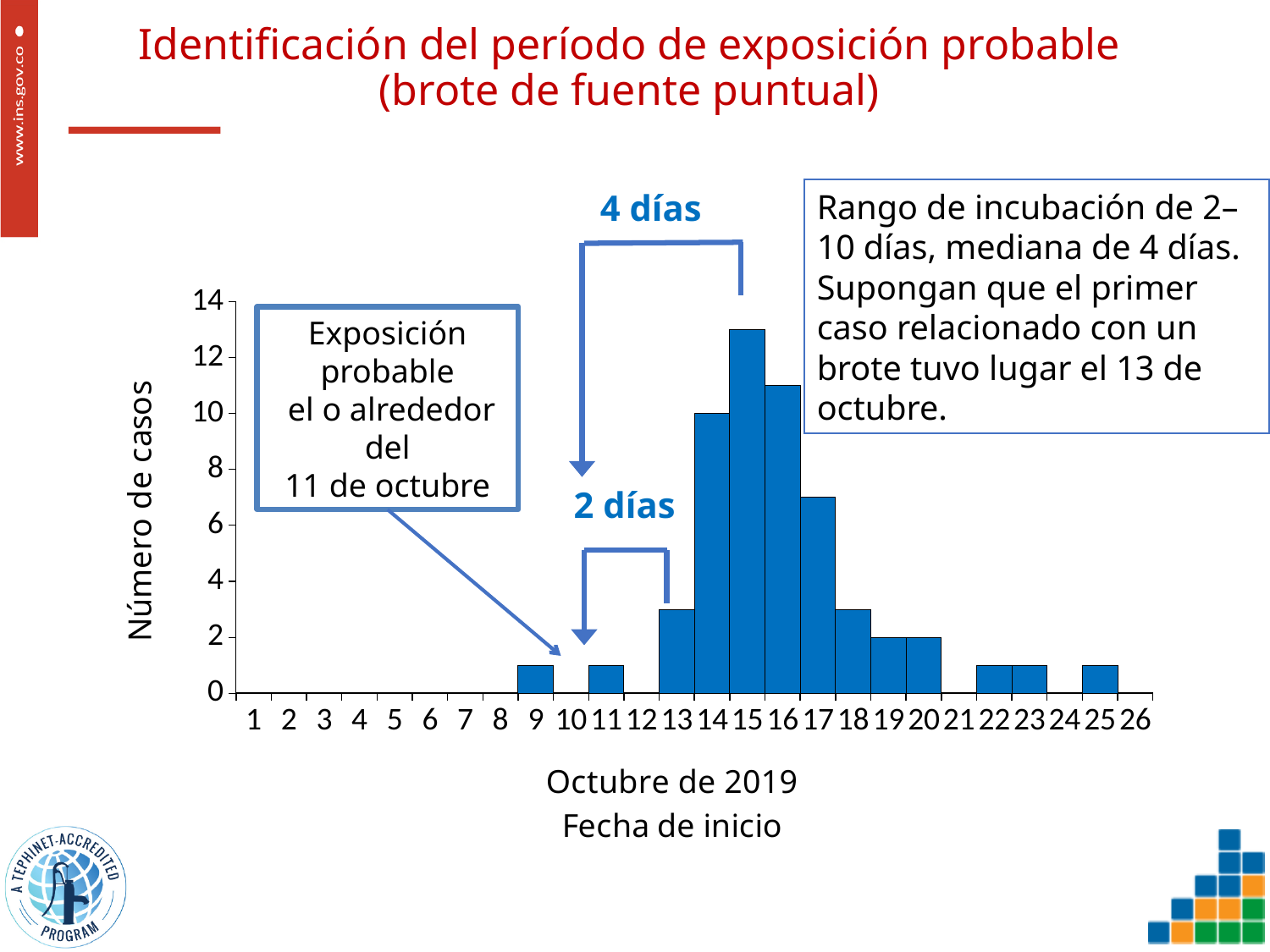
How many cases are shown for 19 October? 2 What is the difference in cases between 14 October and 19 October? 8 How many cases are shown for 20 October? 2 Is the number of cases on 9 October greater or less than 2? less How many cases are shown for 14 October? 10 What type of chart is shown on the slide? bar chart Do the number of cases rise or fall from 15 October to 20 October? fall What is the label of the y axis? Número de casos Is the number of cases on 17 October greater or less than 8? less Which date has the highest number of cases? 15 Is the number of cases on 15 October greater or less than 12? greater Which date has more cases, 17 October or 18 October? 17 October